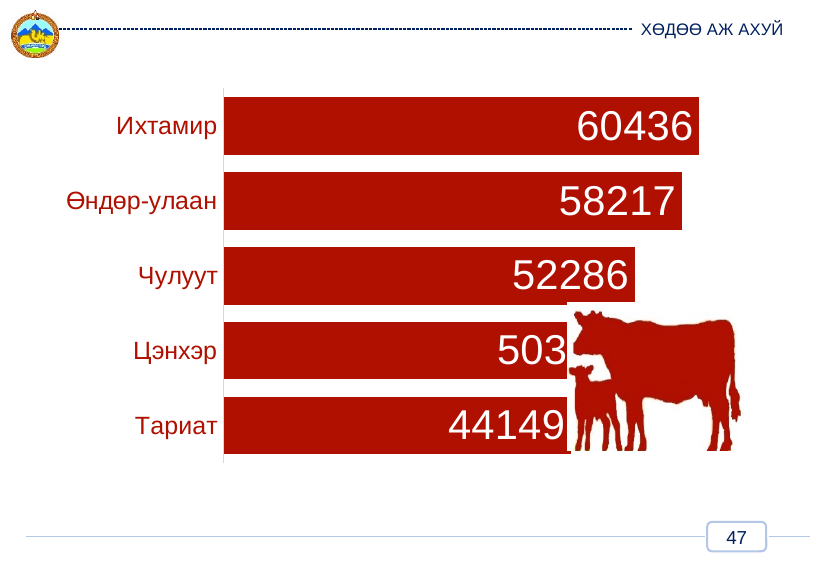
What colour are the bars in the chart? red What is the value for Өндөр-улаан? 58217 Which category has the highest value? Ихтамир Which category has the lowest value? Тариат What is the difference between the values for Чулуут and Тариат? 8137 What kind of chart is shown on the slide? bar chart How many categories are shown in the chart? 5 What is the value for Чулуут? 52286 What is the value for Ихтамир? 60436 What is the value for Тариат? 44149 Which is larger, the value for Өндөр-улаан or the value for Чулуут? Өндөр-улаан What is the difference between the values for Ихтамир and Өндөр-улаан? 2219